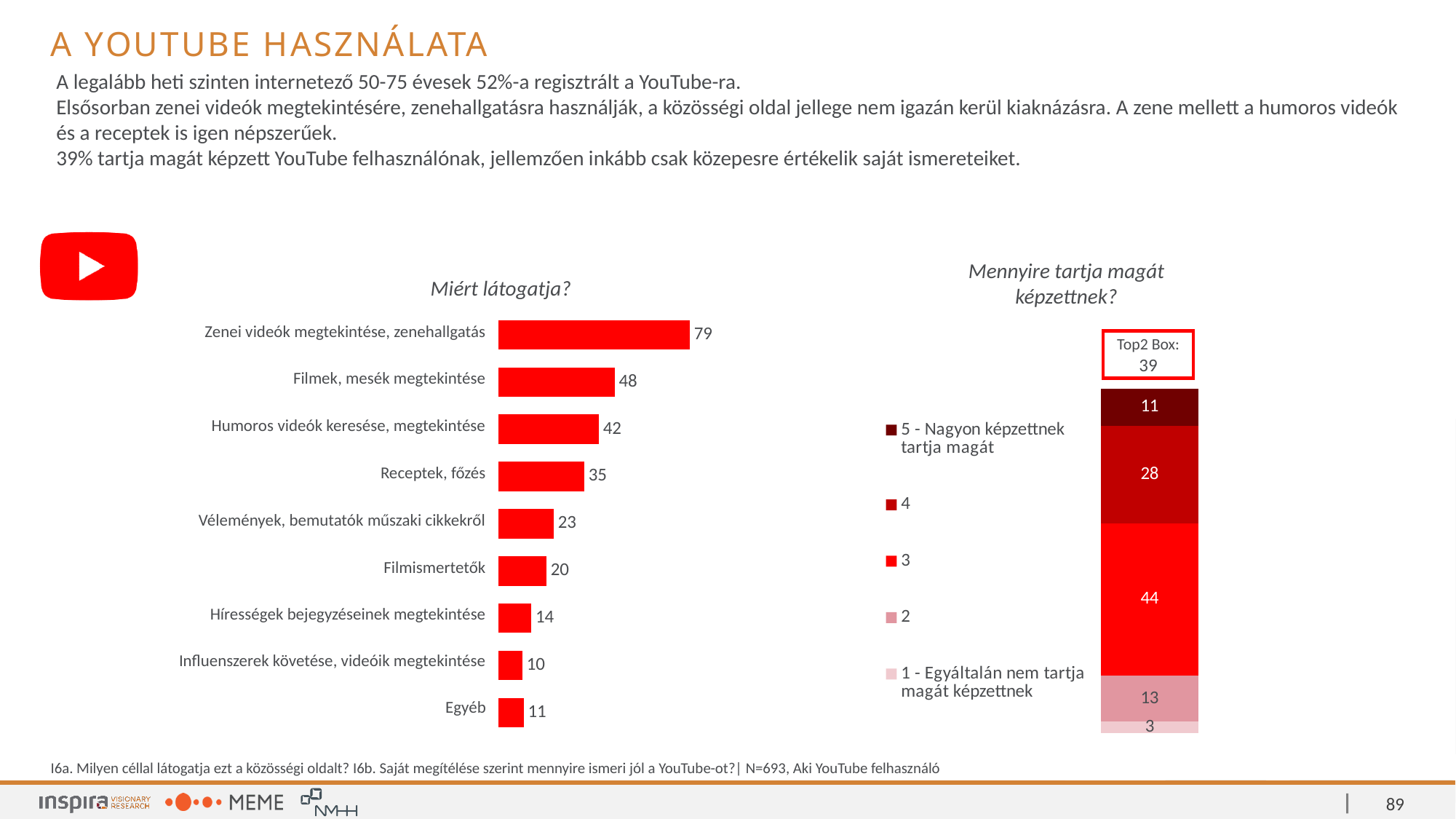
In the "Miért látogatja?" chart, what is the difference between "Filmek, mesék megtekintése" and "Humoros videók keresése, megtekintése"? 6 What value is shown in the "Top2 Box" label above the "Mennyire tartja magát képzettnek?" chart? 39 What kind of chart is the "Miért látogatja?" chart? Bar chart In the "Miért látogatja?" chart, what is the value for "Receptek, főzés"? 35 How many categories are shown in the "Miért látogatja?" chart? 9 In the "Mennyire tartja magát képzettnek?" chart, what is the value for "5 - Nagyon képzettnek tartja magát"? 11 In the "Miért látogatja?" chart, which category has the highest value? Zenei videók megtekintése, zenehallgatás How many series does the legend of the "Mennyire tartja magát képzettnek?" chart list? 5 In the "Miért látogatja?" chart, which is larger: "Filmismertetők" or "Hírességek bejegyzéseinek megtekintése"? Filmismertetők In the "Mennyire tartja magát képzettnek?" chart, what is the value for "3"? 44 In the "Mennyire tartja magát képzettnek?" chart, what is the total of the stacked bar? 99 In the "Miért látogatja?" chart, which category has the lowest value? Influenszerek követése, videóik megtekintése